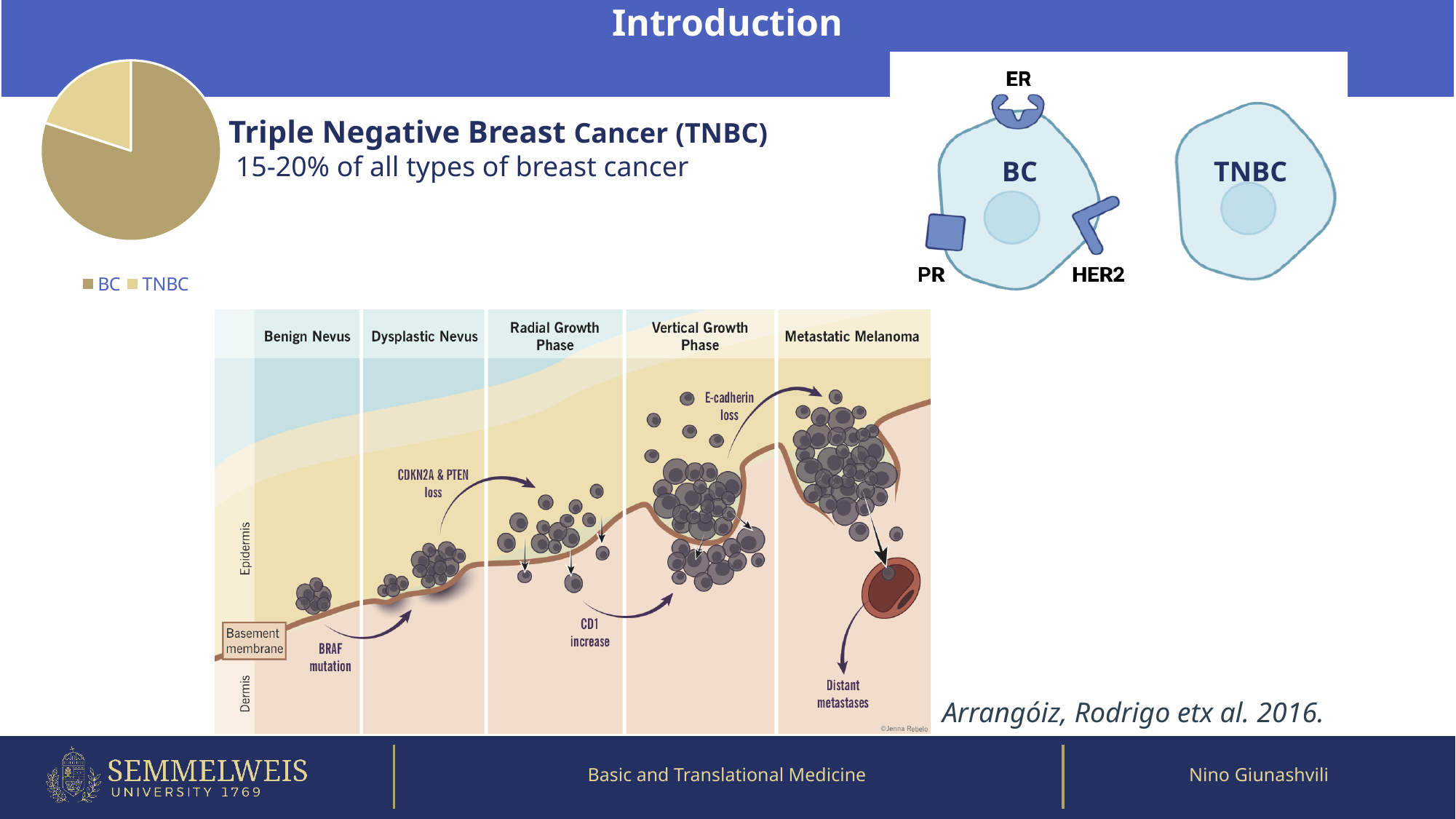
How many entries does the legend of the pie chart list? 2 Which category has the largest slice in the pie chart? BC Which category in the pie chart is shown in the lighter shade? TNBC What kind of chart is shown at the top left of the slide? Pie chart Which category has the smallest slice in the pie chart? TNBC What are the two categories listed in the pie chart's legend? BC and TNBC How many slices does the pie chart have? 2 In the pie chart, which slice is larger, BC or TNBC? BC